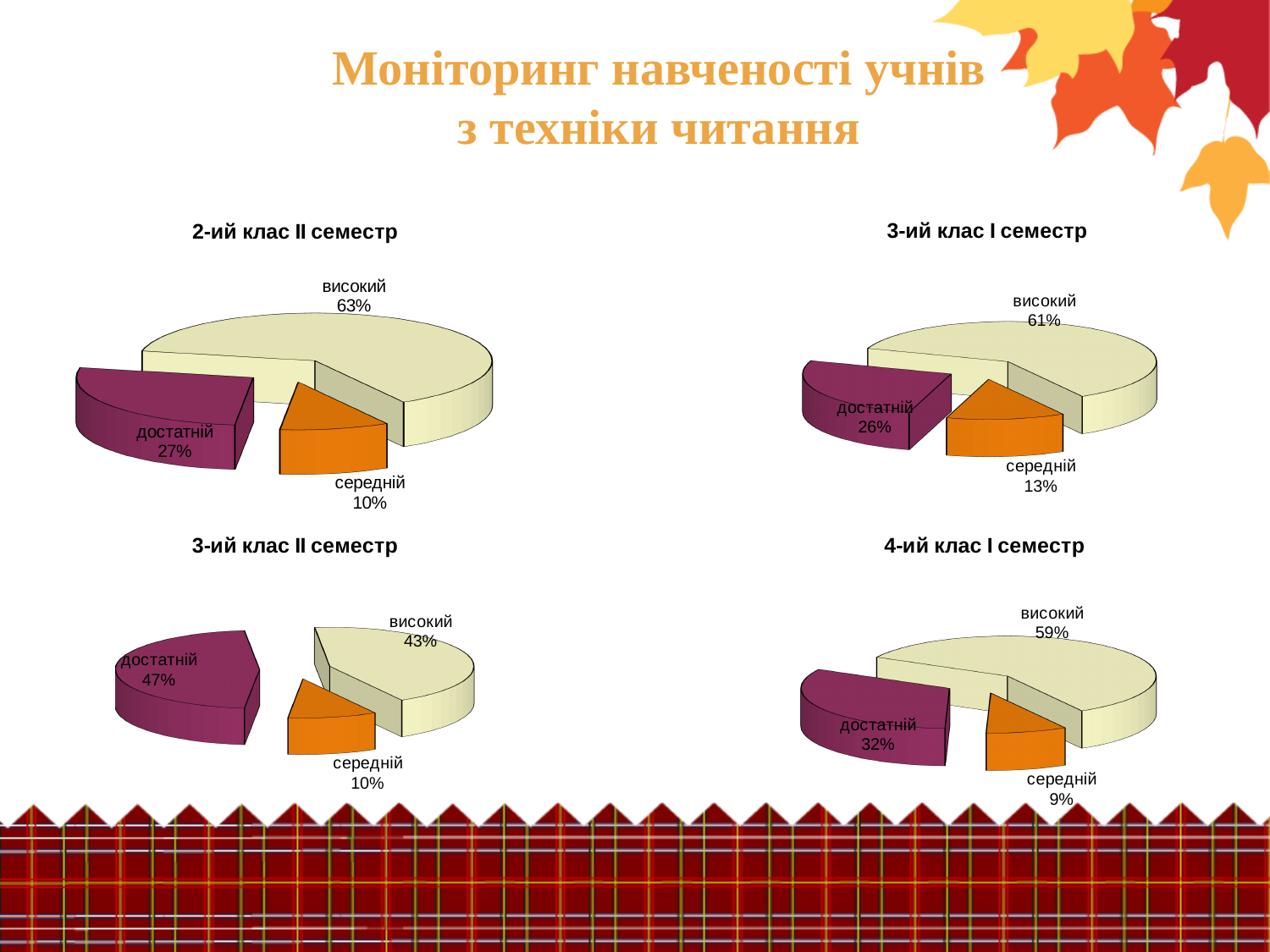
In the chart titled "3-ий клас II семестр", which category has the largest slice? достатній How many charts are shown on the slide? 4 How many slices does the chart titled "2-ий клас II семестр" have? 3 In the chart titled "2-ий клас II семестр", what is the value for "середній"? 10% In the chart titled "4-ий клас I семестр", what is the difference between the "високий" and "достатній" values? 27% In the chart titled "3-ий клас I семестр", which category has the smallest slice? середній In the chart titled "3-ий клас II семестр", what is the difference between the "достатній" and "високий" values? 4% In the chart titled "4-ий клас I семестр", which is larger, "достатній" or "середній"? достатній What type of chart is the one titled "3-ий клас I семестр"? pie chart In the chart titled "4-ий клас I семестр", what is the value for "середній"? 9% In the chart titled "2-ий клас II семестр", what share does the "високий" slice have? 63% In the chart titled "3-ий клас I семестр", what is the value for "достатній"? 26%